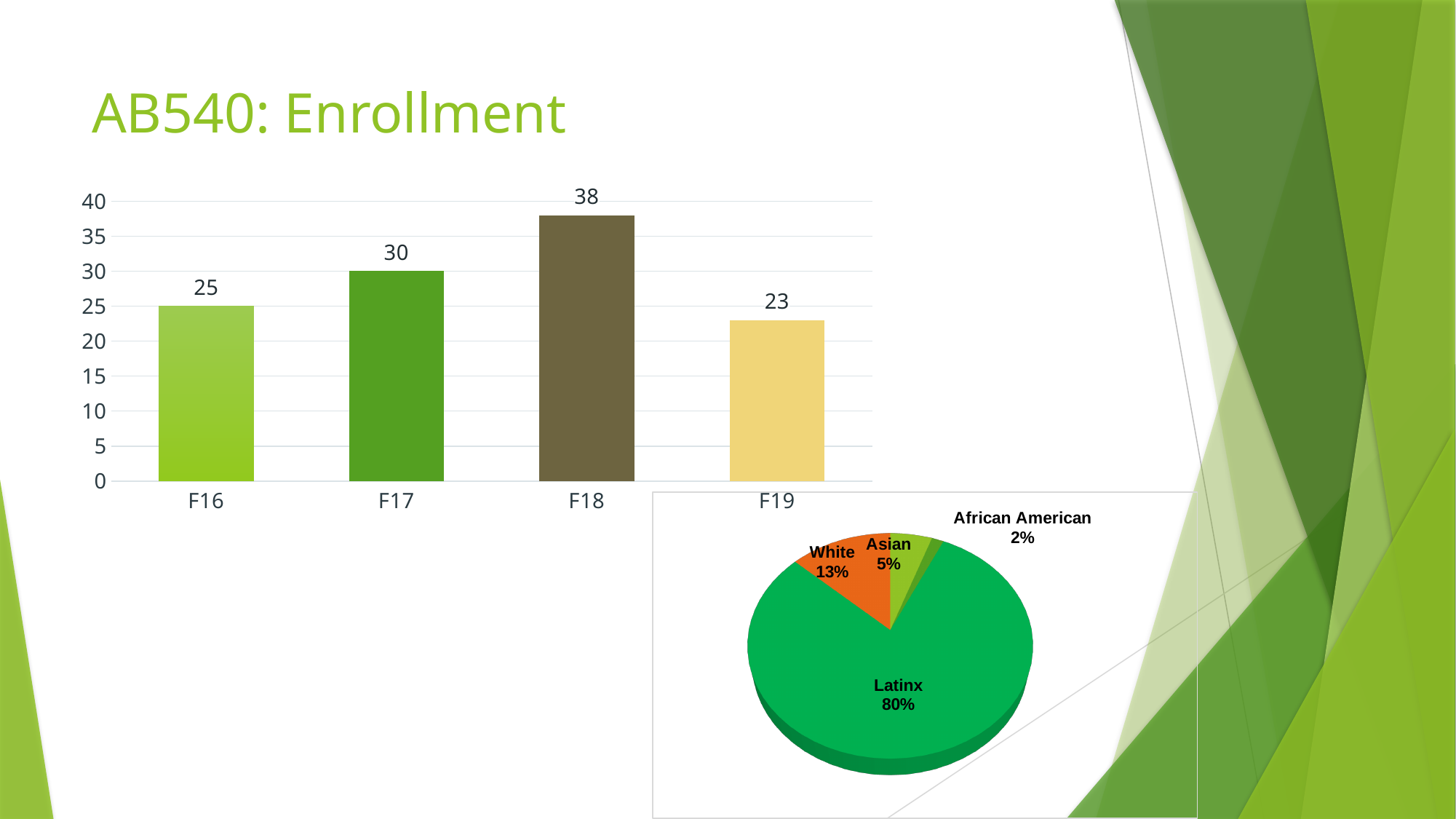
In the bar chart, what is the difference between the values for F18 and F19? 15 How many slices does the pie chart have? 4 In the bar chart, what is the value for F18? 38 In the pie chart, what share does Latinx have? 80% In the bar chart, which is larger, the value for F17 or the value for F16? F17 In the pie chart, which slice is the smallest? African American What kind of chart is the chart on the upper left of the slide? bar chart In the bar chart, which category has the lowest value? F19 How many bars are in the bar chart? 4 In the bar chart, which category has the highest value? F18 In the bar chart, what is the value for F16? 25 In the pie chart, what share does White have? 13%